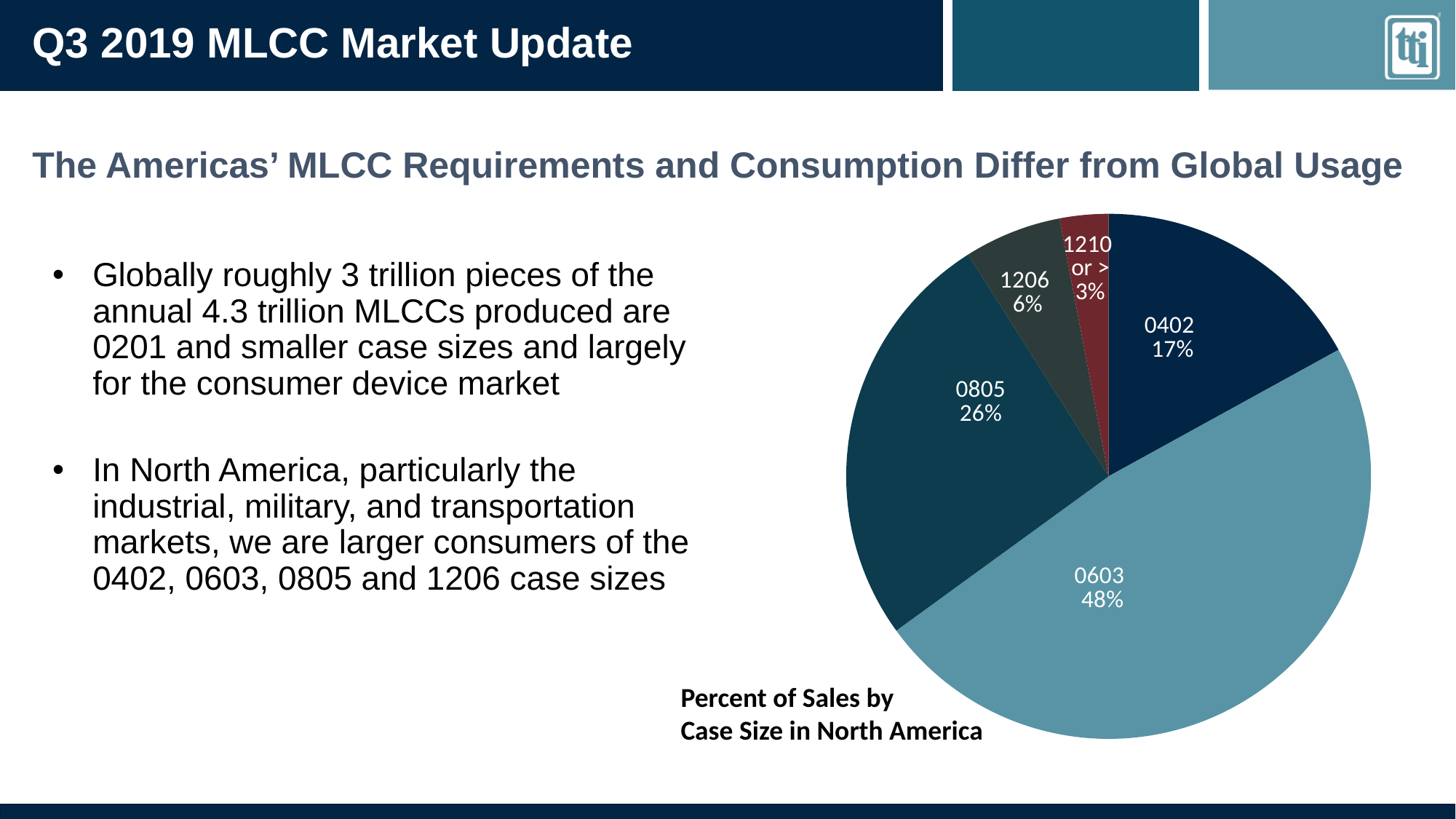
What is the difference in percentage points between the 0603 and 0805 shares? 22 What percentage of sales does the 0805 case size account for? 26% Which has a larger share of sales, 0402 or 0805? 0805 How many case size categories are shown in the pie chart? 5 What percentage of sales does the '1210 or >' case size account for? 3% What percentage of sales does the 0402 case size account for? 17% Which case size has the largest share of sales in the pie chart? 0603 What type of chart is shown on the slide? Pie chart What percentage of sales does the 0603 case size account for in the pie chart? 48% What is the title of the chart on the slide? Percent of Sales by Case Size in North America What percentage of sales does the 1206 case size account for? 6% Which case size has the smallest share of sales in the pie chart? 1210 or >